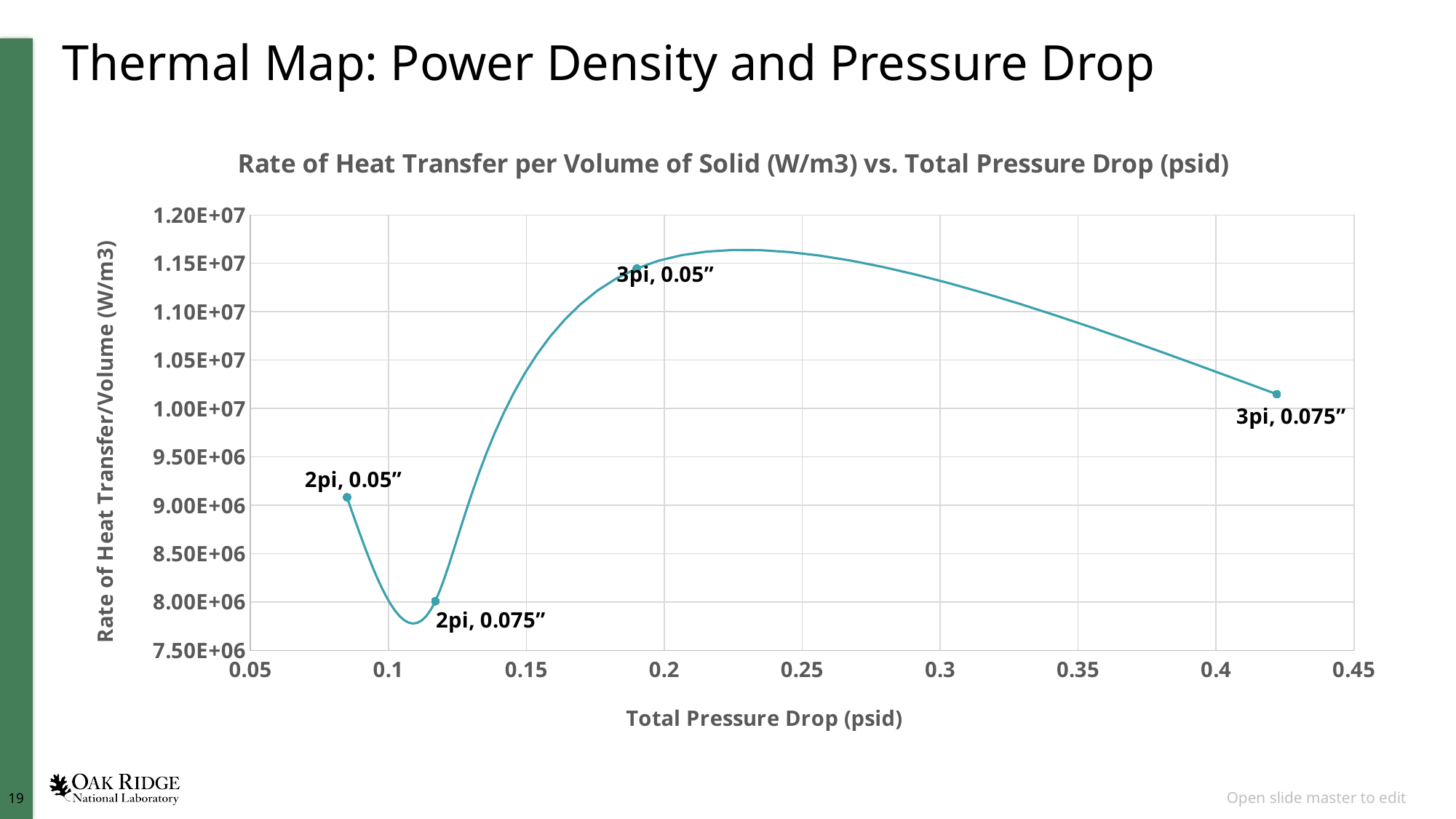
Which labeled point has the lowest total pressure drop? 2pi, 0.05" Which has a higher rate of heat transfer per volume, 3pi, 0.05" or 2pi, 0.05"? 3pi, 0.05" How many labeled data points are plotted on the chart? 4 What is the label of the x axis? Total Pressure Drop (psid) Which labeled point has the highest total pressure drop? 3pi, 0.075" Which labeled point has the highest rate of heat transfer per volume? 3pi, 0.05" What kind of chart is shown on the slide? Line chart (scatter with smoothed line) Is the rate of heat transfer per volume for 3pi, 0.075" greater or less than 1.05E+07? less Is the rate of heat transfer per volume for 3pi, 0.05" greater or less than 1.10E+07? greater Is the total pressure drop for 3pi, 0.075" greater or less than 0.4 psid? greater Which labeled point has the lowest rate of heat transfer per volume? 2pi, 0.075"